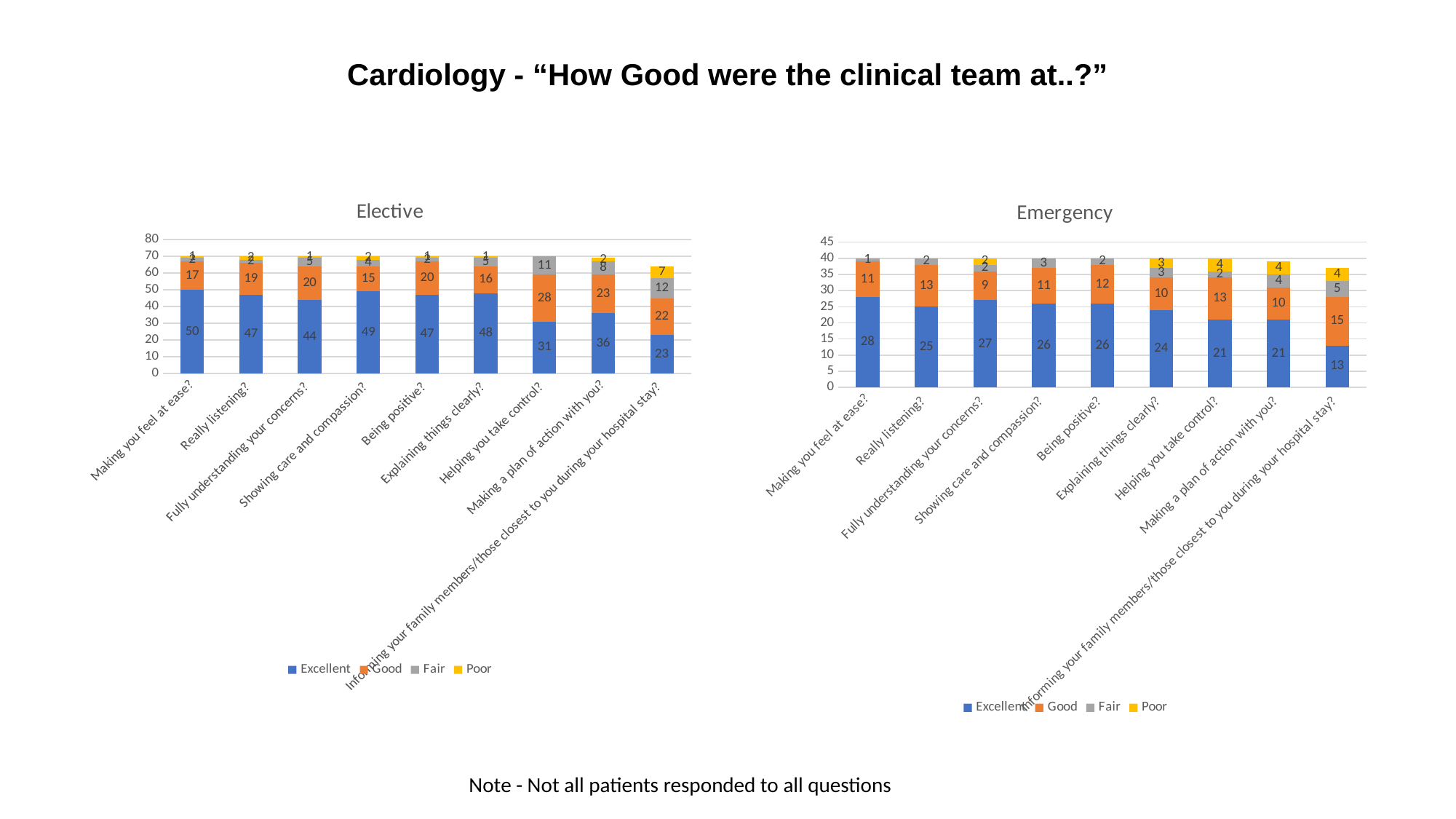
In the Emergency chart, which has the larger Good value: "Really listening?" or "Fully understanding your concerns?"? Really listening? In the Emergency chart, what is the total of the stacked bar for "Informing your family members/those closest to you during your hospital stay?"? 37 In the Elective chart, what is the difference between the Excellent values for "Making you feel at ease?" and "Informing your family members/those closest to you during your hospital stay?"? 27 In the Elective chart, what is the Excellent value for "Making you feel at ease?"? 50 In the Elective chart, what is the Good value for "Helping you take control?"? 28 How many categories are shown on the x axis of the Emergency chart? 9 In the Emergency chart, which category has the lowest Excellent value? Informing your family members/those closest to you during your hospital stay? In the Elective chart, which category has the highest Excellent value? Making you feel at ease? How many series does the legend of the Elective chart list? 4 In the Elective chart, which category has the lowest Excellent value? Informing your family members/those closest to you during your hospital stay? In the Emergency chart, what is the Excellent value for "Really listening?"? 25 In the Emergency chart, what is the Good value for "Informing your family members/those closest to you during your hospital stay?"? 15